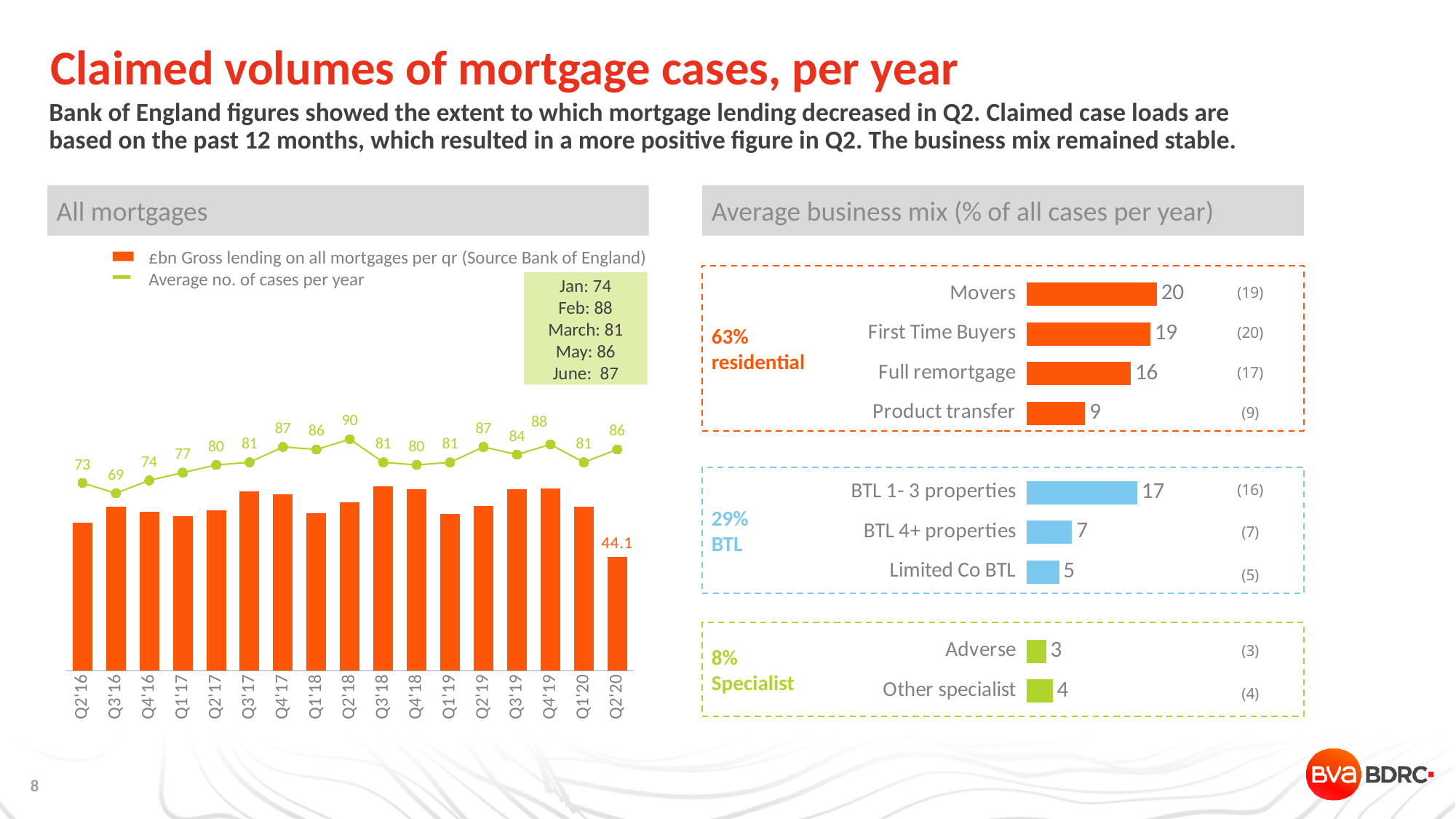
In the 'All mortgages' chart, what is the average number of cases per year for Q2'18? 90 In the 'Average business mix' chart, what is the difference between BTL 1- 3 properties and BTL 4+ properties? 10 In the 'All mortgages' chart, what is the £bn gross lending value labelled for Q2'20? 44.1 In the 'Average business mix' chart, what is the value for Full remortgage? 16 In the 'All mortgages' chart, which quarter has the lowest average number of cases per year? Q3'16 What kind of chart is the 'Average business mix' chart? Bar chart In the 'All mortgages' chart, how many quarters are shown on the x axis? 17 In the 'All mortgages' chart, how many series does the legend list? 2 In the 'All mortgages' chart, which quarter has the highest average number of cases per year? Q2'18 In the 'Average business mix' chart, which category has the highest value? Movers In the 'Average business mix' chart, which category has the lowest value? Adverse In the 'All mortgages' chart, what is the difference between the average number of cases per year in Q2'18 and Q3'16? 21